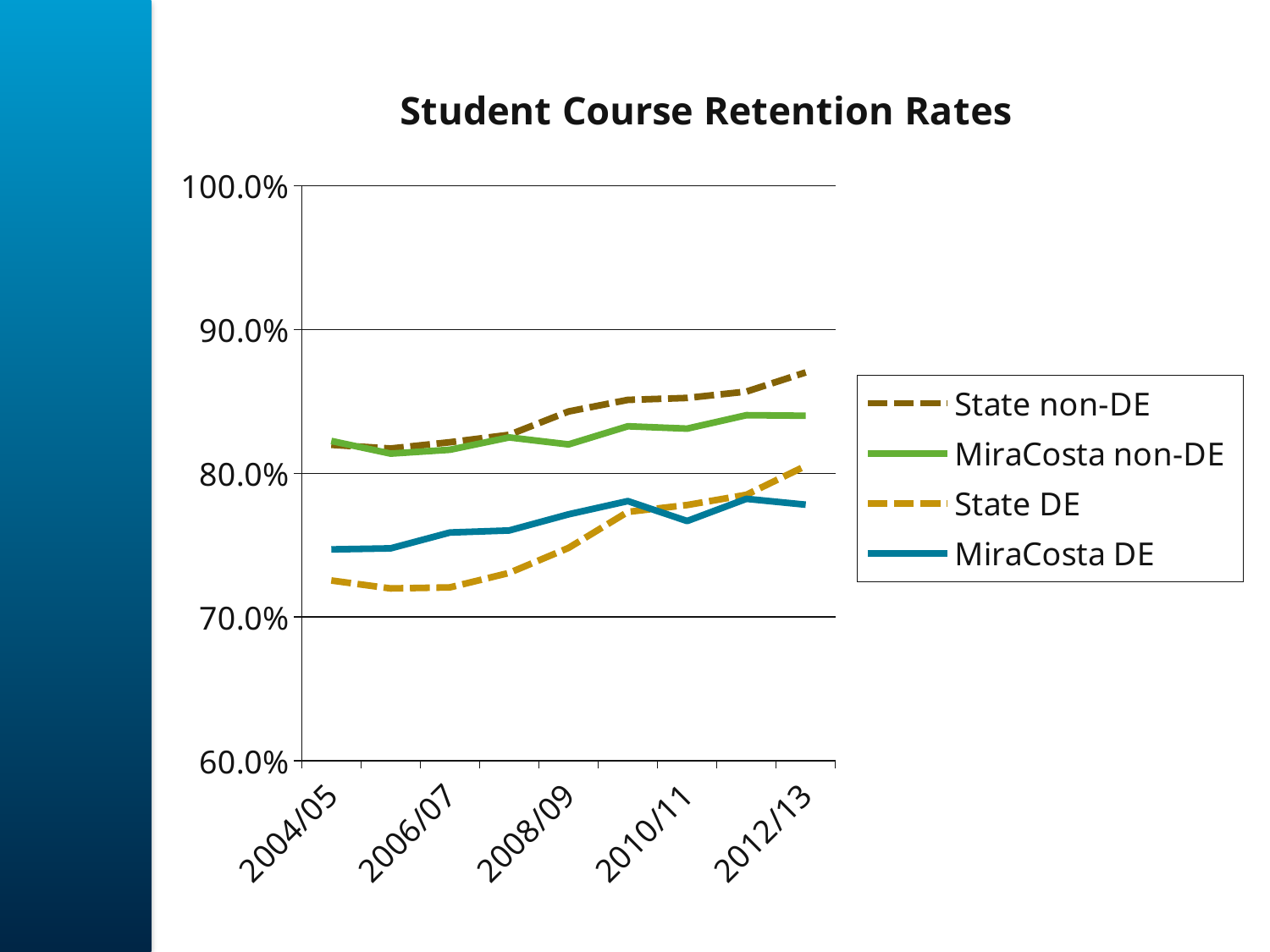
How many series does the legend list? 4 In 2012/13, which is larger: State non-DE or MiraCosta non-DE? State non-DE What is the title of the chart? Student Course Retention Rates Which series has the lowest value in 2004/05? State DE What kind of chart is shown on the slide? line chart Which series has the highest value in 2012/13? State non-DE Does the State DE series generally rise or fall from 2004/05 to 2012/13? rise In 2004/05, which is larger: State DE or MiraCosta DE? MiraCosta DE Is the value for State non-DE in 2012/13 greater or less than 90.0%? less Is the value for MiraCosta DE in 2004/05 greater or less than 70.0%? greater Is the value for State DE in 2004/05 greater or less than 80.0%? less